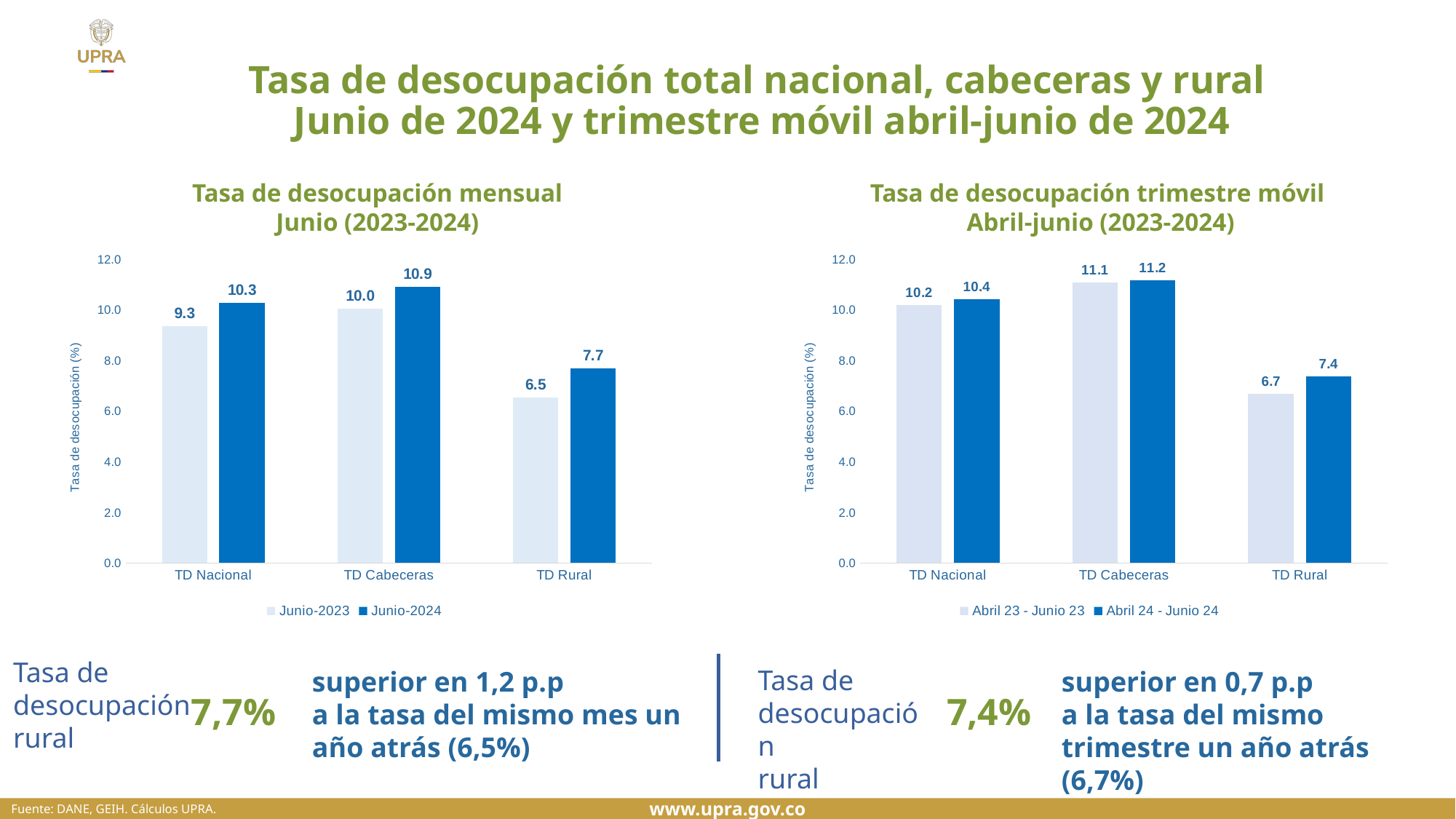
In the 'Tasa de desocupación trimestre móvil Abril-junio (2023-2024)' chart, what is the value for TD Rural in Abril 23 - Junio 23? 6.7 In the 'Tasa de desocupación mensual Junio (2023-2024)' chart, what is the value for TD Rural in Junio-2024? 7.7 In the 'Tasa de desocupación mensual Junio (2023-2024)' chart, which is larger: the Junio-2023 value for TD Nacional or the Junio-2023 value for TD Cabeceras? TD Cabeceras In the 'Tasa de desocupación trimestre móvil Abril-junio (2023-2024)' chart, which category has the lowest Abril 23 - Junio 23 value? TD Rural In the 'Tasa de desocupación mensual Junio (2023-2024)' chart, what is the difference between the Junio-2024 and Junio-2023 values for TD Nacional? 1.0 How many series does the legend of the 'Tasa de desocupación mensual Junio (2023-2024)' chart list? 2 What type of chart is the 'Tasa de desocupación trimestre móvil Abril-junio (2023-2024)' chart? Bar chart In the 'Tasa de desocupación trimestre móvil Abril-junio (2023-2024)' chart, what is the value for TD Nacional in Abril 24 - Junio 24? 10.4 In the 'Tasa de desocupación mensual Junio (2023-2024)' chart, which category has the highest Junio-2024 value? TD Cabeceras In the 'Tasa de desocupación mensual Junio (2023-2024)' chart, what is the value for TD Cabeceras in Junio-2023? 10.0 In the 'Tasa de desocupación trimestre móvil Abril-junio (2023-2024)' chart, what is the difference between the Abril 24 - Junio 24 and Abril 23 - Junio 23 values for TD Rural? 0.7 How many categories are shown on the x axis of the 'Tasa de desocupación trimestre móvil Abril-junio (2023-2024)' chart? 3